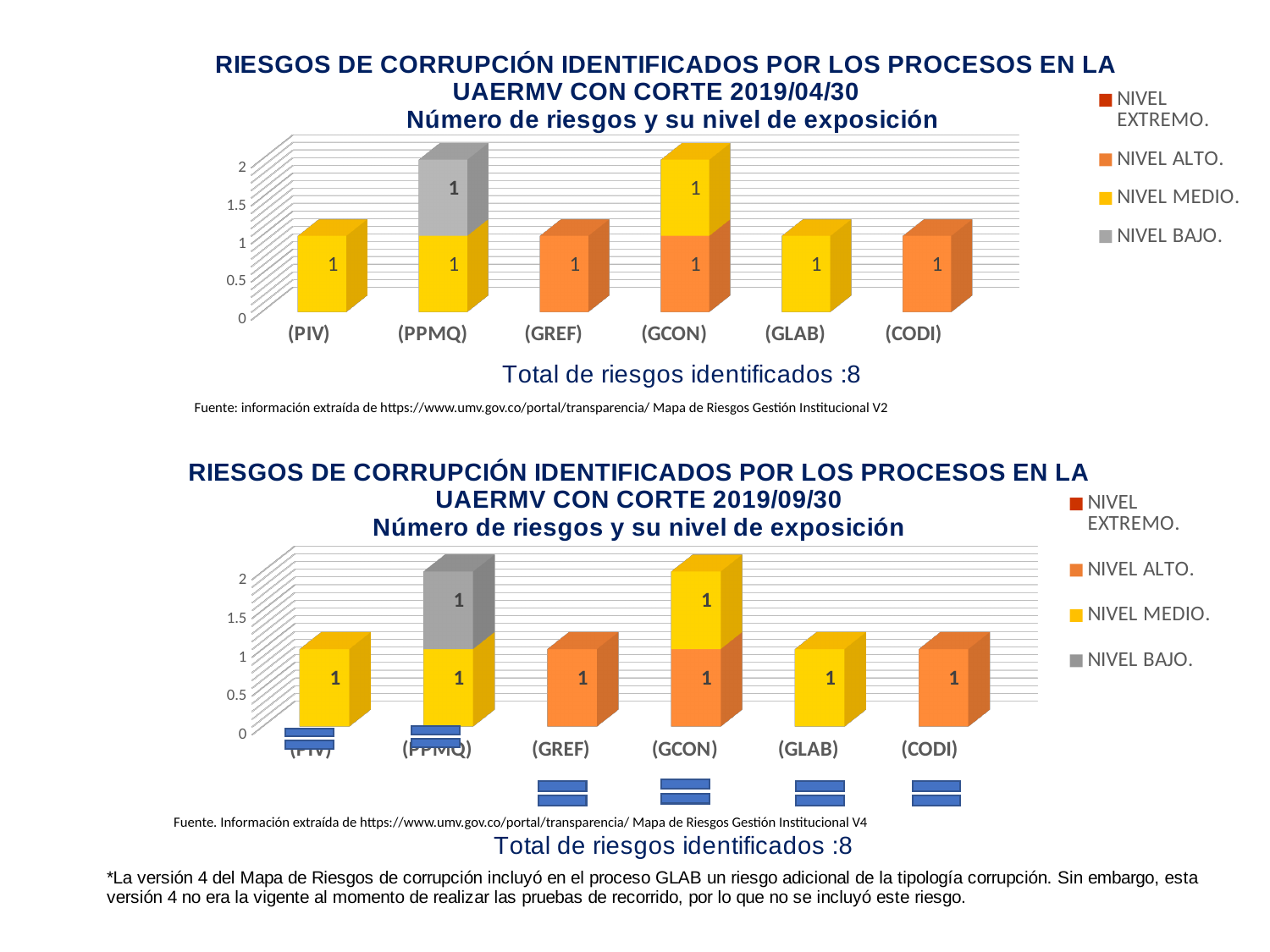
In the bottom chart (corte 2019/09/30), what is the NIVEL ALTO value for (GREF)? 1 In the top chart (corte 2019/04/30), what is the NIVEL MEDIO value for (GCON)? 1 In the top chart (corte 2019/04/30), how many categories are shown on the x axis? 6 In the top chart (corte 2019/04/30), how many series does the legend list? 4 In the top chart (corte 2019/04/30), what is the NIVEL BAJO value for (PPMQ)? 1 What kind of chart is the top chart (corte 2019/04/30)? Stacked bar chart In the bottom chart (corte 2019/09/30), which is larger, the total bar for (PPMQ) or the total bar for (PIV)? (PPMQ) What is the subtitle shown under the main title of the top chart? Número de riesgos y su nivel de exposición In the bottom chart (corte 2019/09/30), what is the total of the stacked bar for (GCON)? 2 In the top chart (corte 2019/04/30), what is the total of the stacked bar for (PPMQ)? 2 In the bottom chart (corte 2019/09/30), what is the difference between the total bar for (GCON) and the total bar for (CODI)? 1 In the bottom chart (corte 2019/09/30), which series is shown in grey in the legend? NIVEL BAJO.